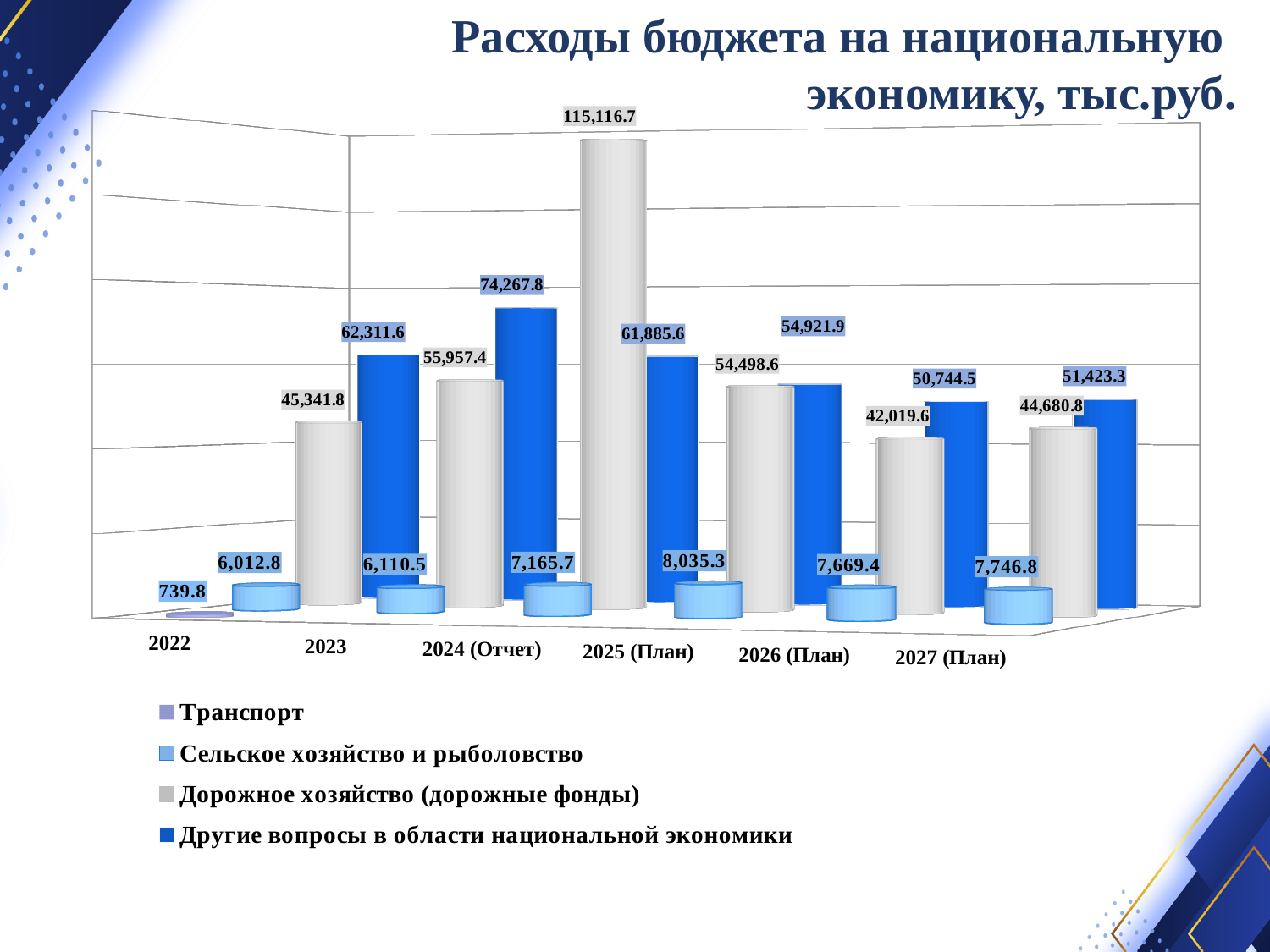
What is the difference between Дорожное хозяйство (дорожные фонды) and Другие вопросы в области национальной экономики in 2025 (План)? 423.3 How many year categories are shown on the x axis? 6 What is the value for Дорожное хозяйство (дорожные фонды) in 2025 (План)? 54,498.6 Does the value for Дорожное хозяйство (дорожные фонды) rise or fall from 2025 (План) to 2027 (План)? Fall In 2026 (План), which is larger: Дорожное хозяйство (дорожные фонды) or Другие вопросы в области национальной экономики? Другие вопросы в области национальной экономики How many series does the legend list? 4 What is the value for Транспорт in 2022? 739.8 In which year is the value for Дорожное хозяйство (дорожные фонды) the highest? 2024 (Отчет) What is the value for Сельское хозяйство и рыболовство in 2027 (План)? 7,746.8 In which year is the value for Сельское хозяйство и рыболовство the lowest? 2022 What kind of chart is shown on the slide? Bar chart What is the value for Другие вопросы в области национальной экономики in 2024 (Отчет)? 61,885.6